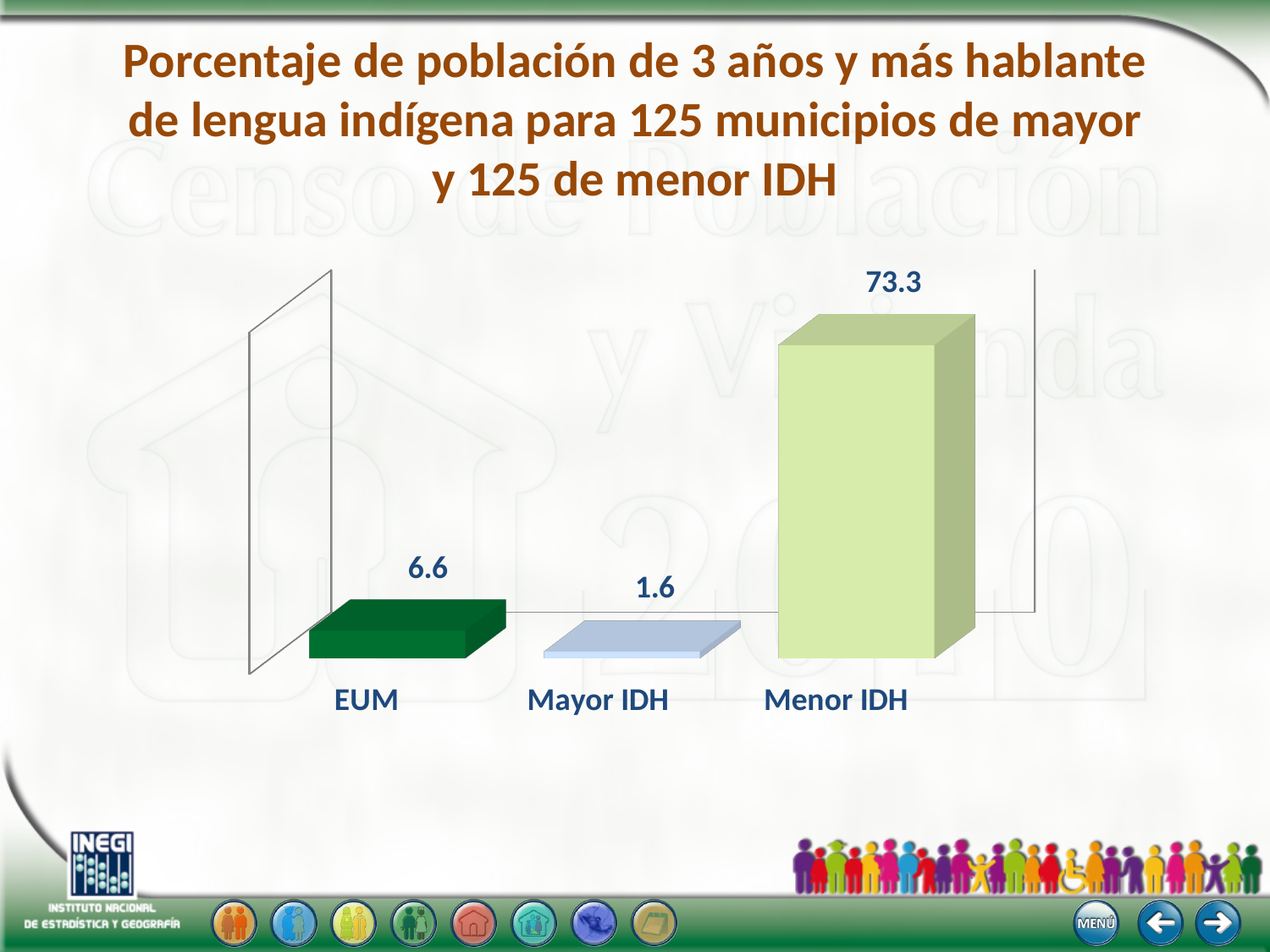
Which category has the lowest value? Mayor IDH Which is larger, the value for EUM or the value for Mayor IDH? EUM What kind of chart is shown on the slide? Bar chart What is the difference between the values for Menor IDH and EUM? 66.7 What is the title of the chart? Porcentaje de población de 3 años y más hablante de lengua indígena para 125 municipios de mayor y 125 de menor IDH What is the value for Mayor IDH? 1.6 What is the value for Menor IDH? 73.3 What is the value for EUM? 6.6 Which category has the highest value? Menor IDH How many categories are shown in the chart? 3 What colour is the bar for EUM? Dark green What is the difference between the values for EUM and Mayor IDH? 5.0